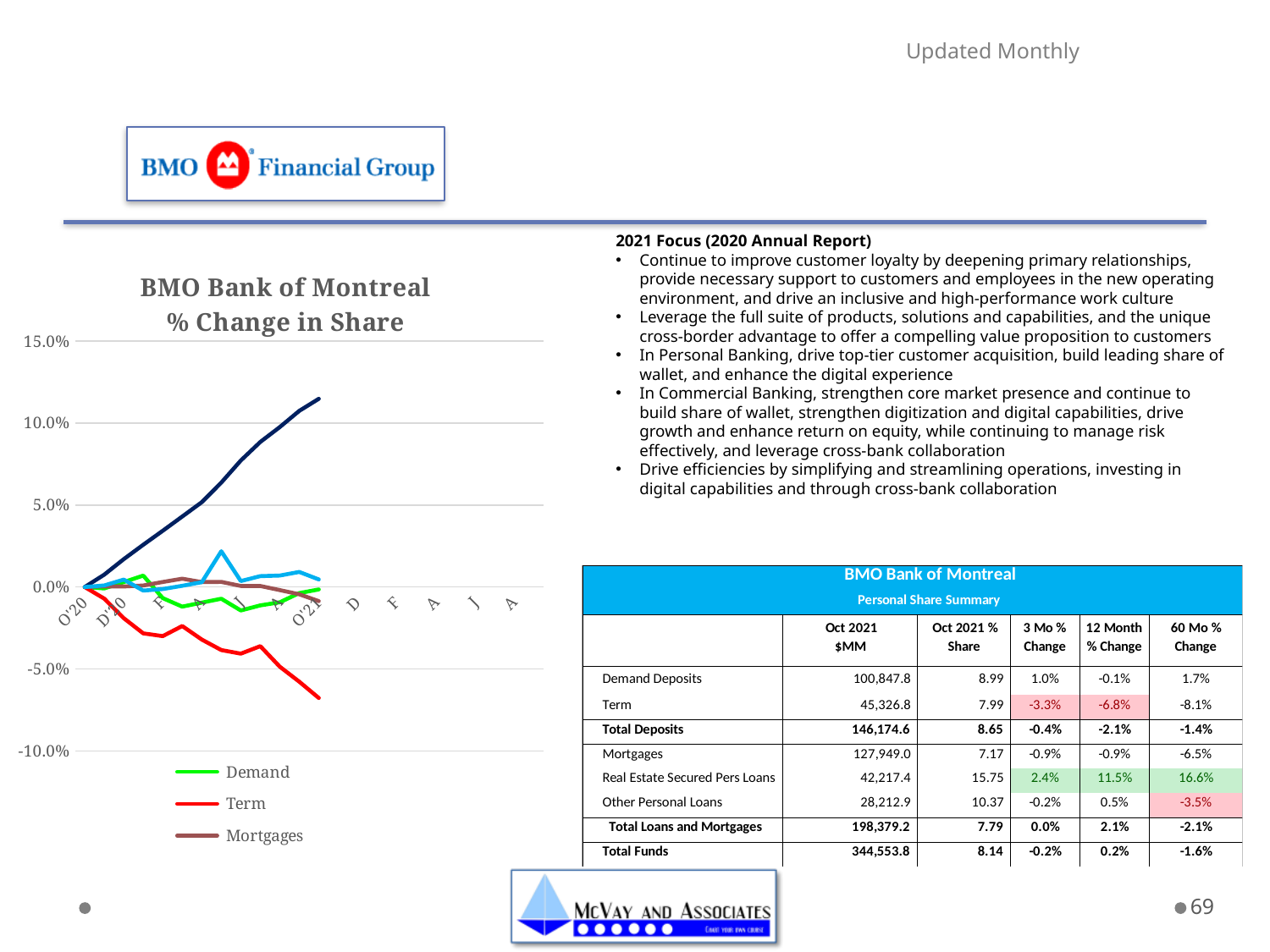
What kind of chart is shown on the slide? line chart Does the Term line rise or fall from O'20 to O'21? fall Among the series listed in the legend, which has the lowest value at O'21? Term At O'21, which is higher, Demand or Term? Demand What is the highest value shown on the chart's y axis? 15.0% What is the title of the chart on the slide? BMO Bank of Montreal % Change in Share Is the value for Term at D'20 greater or less than 0.0%? less How many series does the chart's legend list? 3 Is the value for Term at O'21 greater or less than -5.0%? less Is the value for Mortgages at O'21 greater or less than 5.0%? less Which series is shown in red in the chart's legend? Term